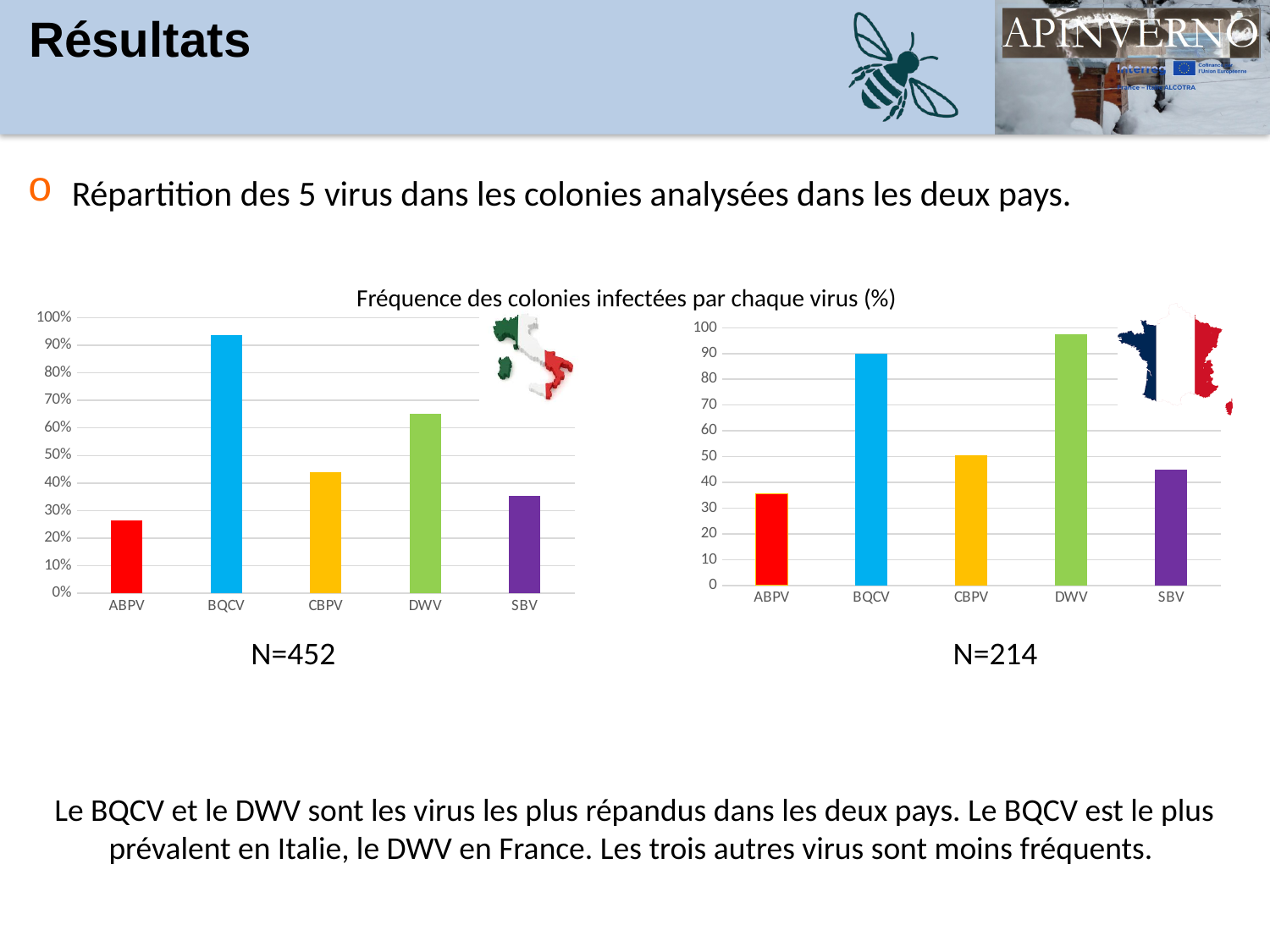
On the right chart (N=214), is the value for SBV greater or less than 50? less On the left chart (N=452), is the value for DWV greater or less than 60%? greater How many virus categories are shown on the left chart (N=452)? 5 On the right chart (N=214), which virus has the highest frequency? DWV On the left chart (N=452), which virus has the lowest frequency? ABPV On the left chart (N=452), which virus has the highest frequency? BQCV On the right chart (N=214), which is larger, the value for DWV or the value for CBPV? DWV On the right chart (N=214), which virus has the lowest frequency? ABPV On the left chart (N=452), is the value for ABPV greater or less than 30%? less On the left chart (N=452), which is larger, the value for CBPV or the value for SBV? CBPV What type of chart is the right chart (N=214)? bar chart